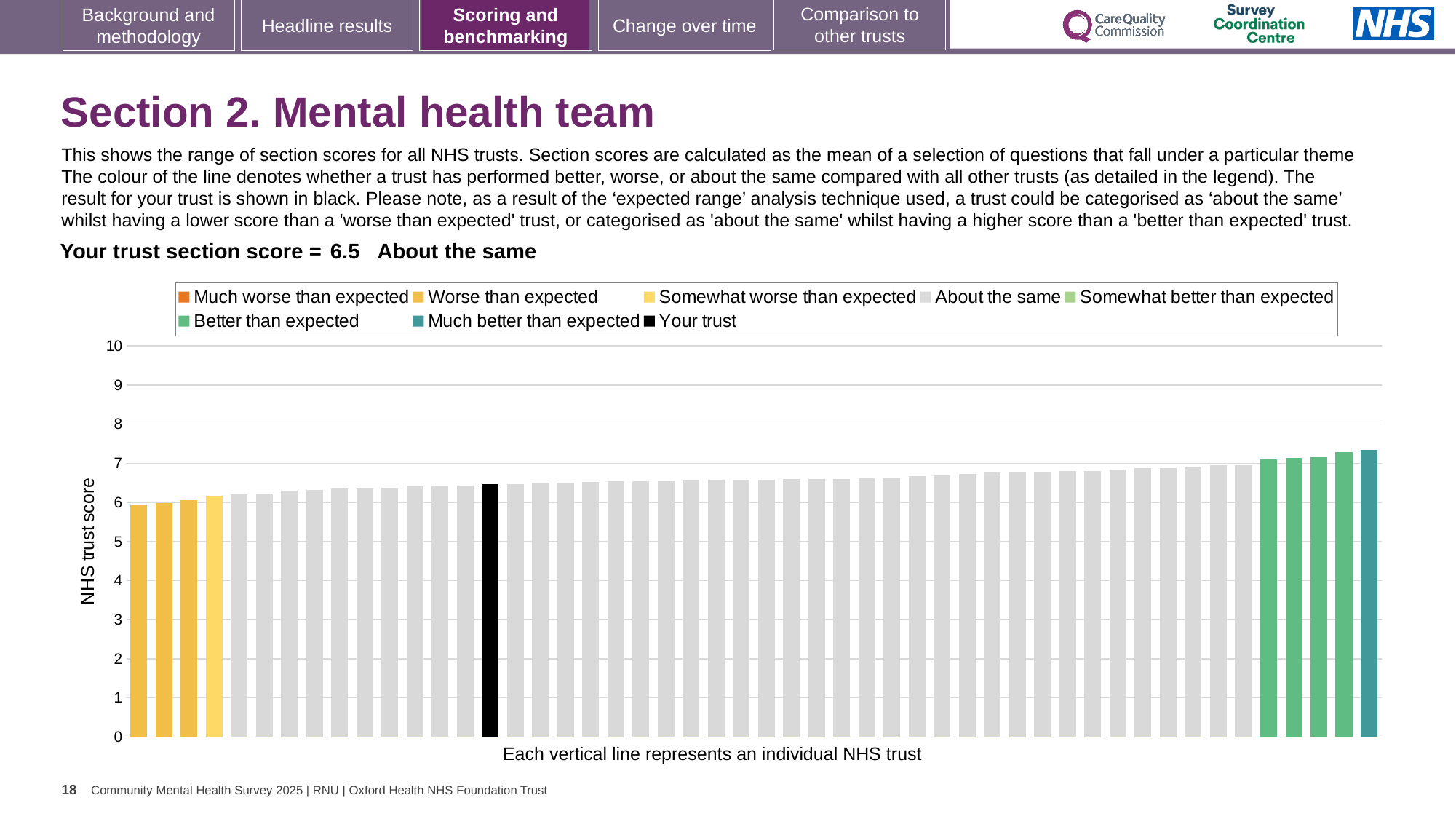
How many entries does the chart legend list? 8 What is the label on the y axis of the chart? NHS trust score Is the value for the highest-scoring trust greater or less than 7? greater How many bars on the chart are coloured black? 1 Is the value for the lowest-scoring trust greater or less than 5? greater Do the trust scores rise or fall moving from left to right along the x axis? Rise What is the section score for your trust shown on the slide? 6.5 How is your trust's section score categorised compared with other trusts? About the same Is the value for the highest-scoring trust greater or less than 8? less What kind of chart is used to show the NHS trust section scores? Bar chart What is the maximum value shown on the y axis? 10